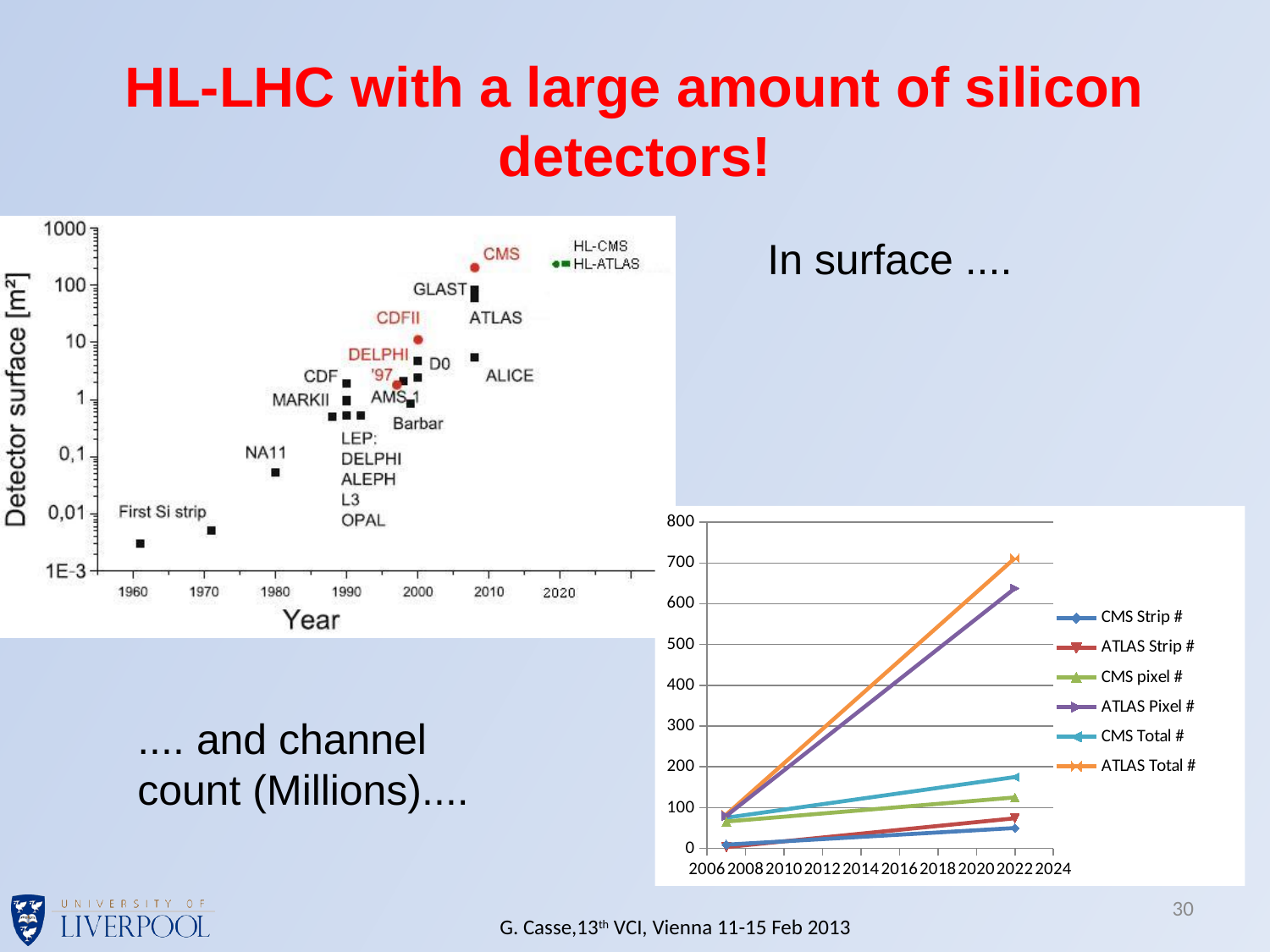
In the bottom-right channel count chart, do the values of the ATLAS Total # series rise or fall from left to right? rise In the bottom-right channel count chart, is the value of CMS Total # at its right-hand end greater or less than 300? less In the top-left detector surface chart, which labelled experiment has the highest plotted detector surface? CMS What kind of chart is the top-left chart of detector surface versus year? scatter chart In the bottom-right channel count chart, is the value of ATLAS Total # at its right-hand end greater or less than 600? greater In the top-left detector surface chart, is the plotted detector surface for CMS greater or less than 100 m²? greater In the bottom-right channel count chart, which series has the lowest value at the right-hand end (around 2022)? CMS Strip # What is the y-axis label of the top-left chart? Detector surface [m²] What kind of chart is the bottom-right chart showing channel count? line chart In the bottom-right channel count chart, which is larger at the right-hand end: ATLAS Pixel # or CMS pixel #? ATLAS Pixel # In the bottom-right channel count chart, which series reaches the highest value at the right-hand end (around 2022)? ATLAS Total # How many series does the legend of the bottom-right channel count chart list? 6